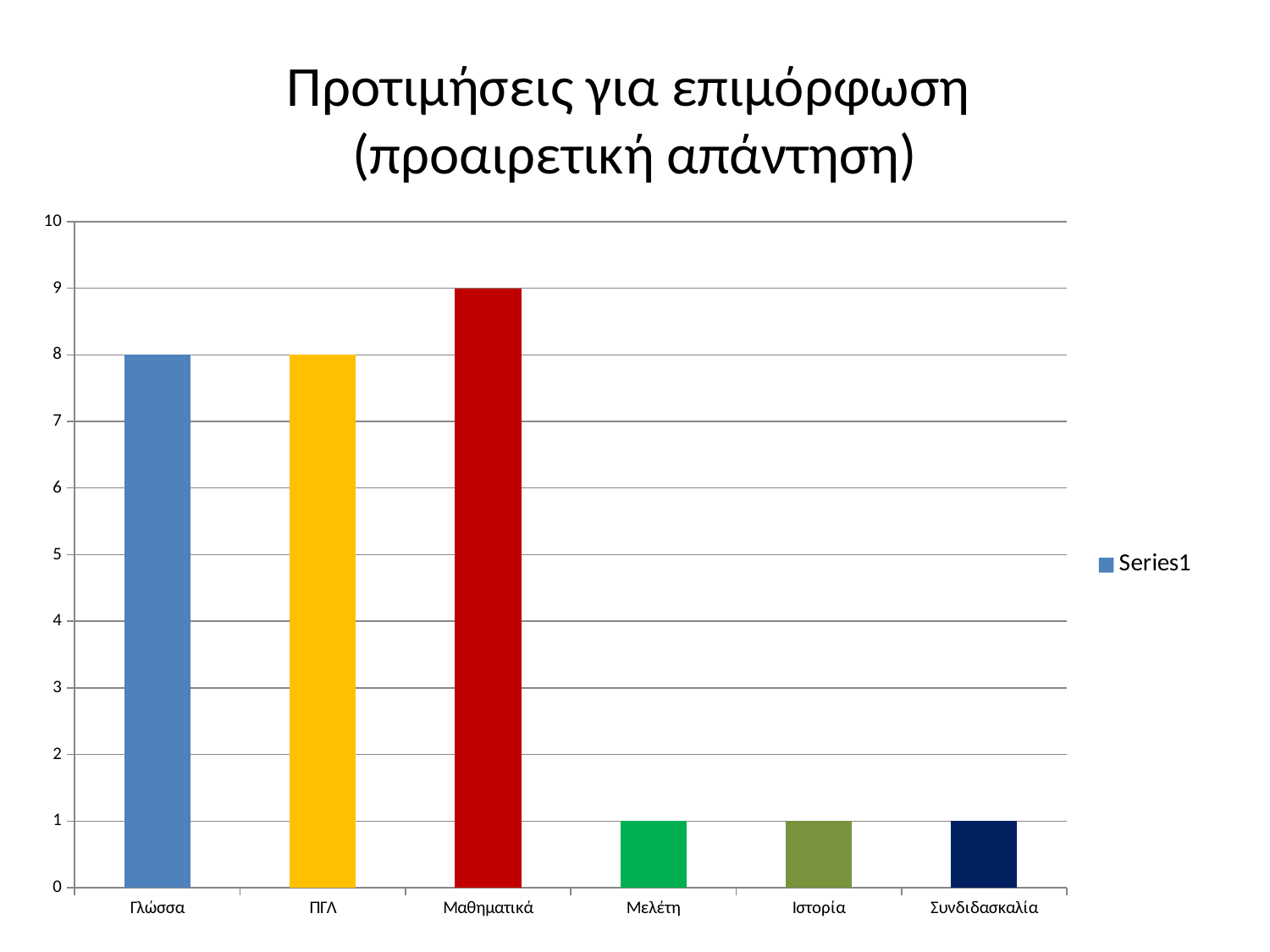
What is the value for Γλώσσα? 8 What is the value for Μαθηματικά? 9 Which category has the highest value? Μαθηματικά How many categories are shown on the x axis? 6 What is the difference between the values for ΠΓΛ and Ιστορία? 7 What is the value for Μελέτη? 1 Is the value for Συνδιδασκαλία greater or less than 5? less How many series does the legend list? 1 Which is larger, the value for Μαθηματικά or the value for ΠΓΛ? Μαθηματικά What kind of chart is shown on the slide? bar chart What is the difference between the values for Μαθηματικά and Γλώσσα? 1 What is the value for ΠΓΛ? 8